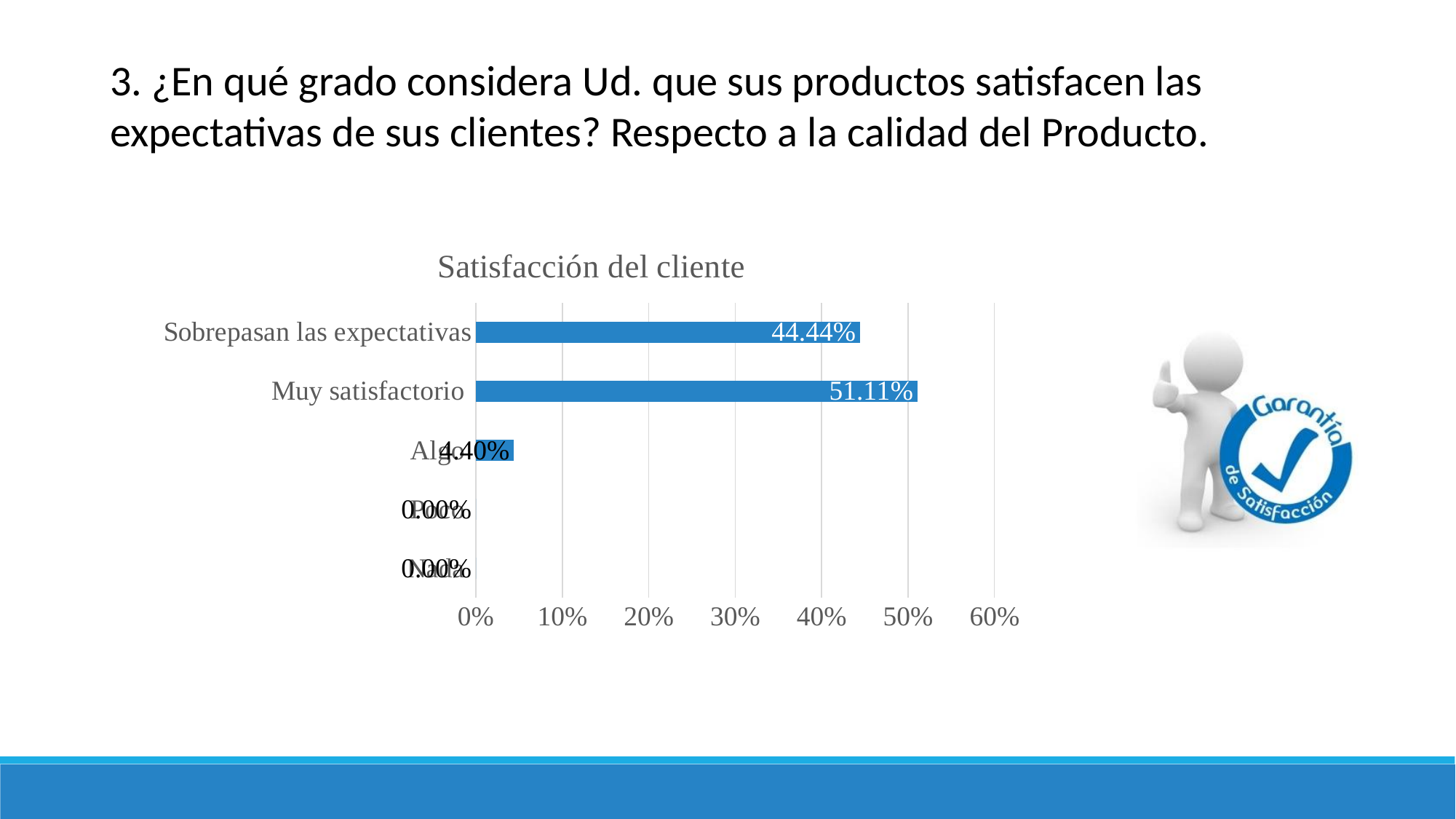
How many categories are shown in the Satisfacción del cliente chart? 5 What is the highest tick value shown on the horizontal axis of the chart? 60% What is the difference between the values for "Muy satisfactorio" and "Sobrepasan las expectativas"? 6.67% Is the value for "Sobrepasan las expectativas" greater or less than 40%? greater What is the value for "Sobrepasan las expectativas" in the Satisfacción del cliente chart? 44.44% What kind of chart is shown on the slide? bar chart Is the value for "Muy satisfactorio" greater or less than 50%? greater Which category has the highest value in the Satisfacción del cliente chart? Muy satisfactorio Which is larger, the value for "Muy satisfactorio" or for "Sobrepasan las expectativas"? Muy satisfactorio What is the title of the chart on the slide? Satisfacción del cliente Is the value for "Sobrepasan las expectativas" greater or less than 50%? less What is the value for "Muy satisfactorio" in the Satisfacción del cliente chart? 51.11%